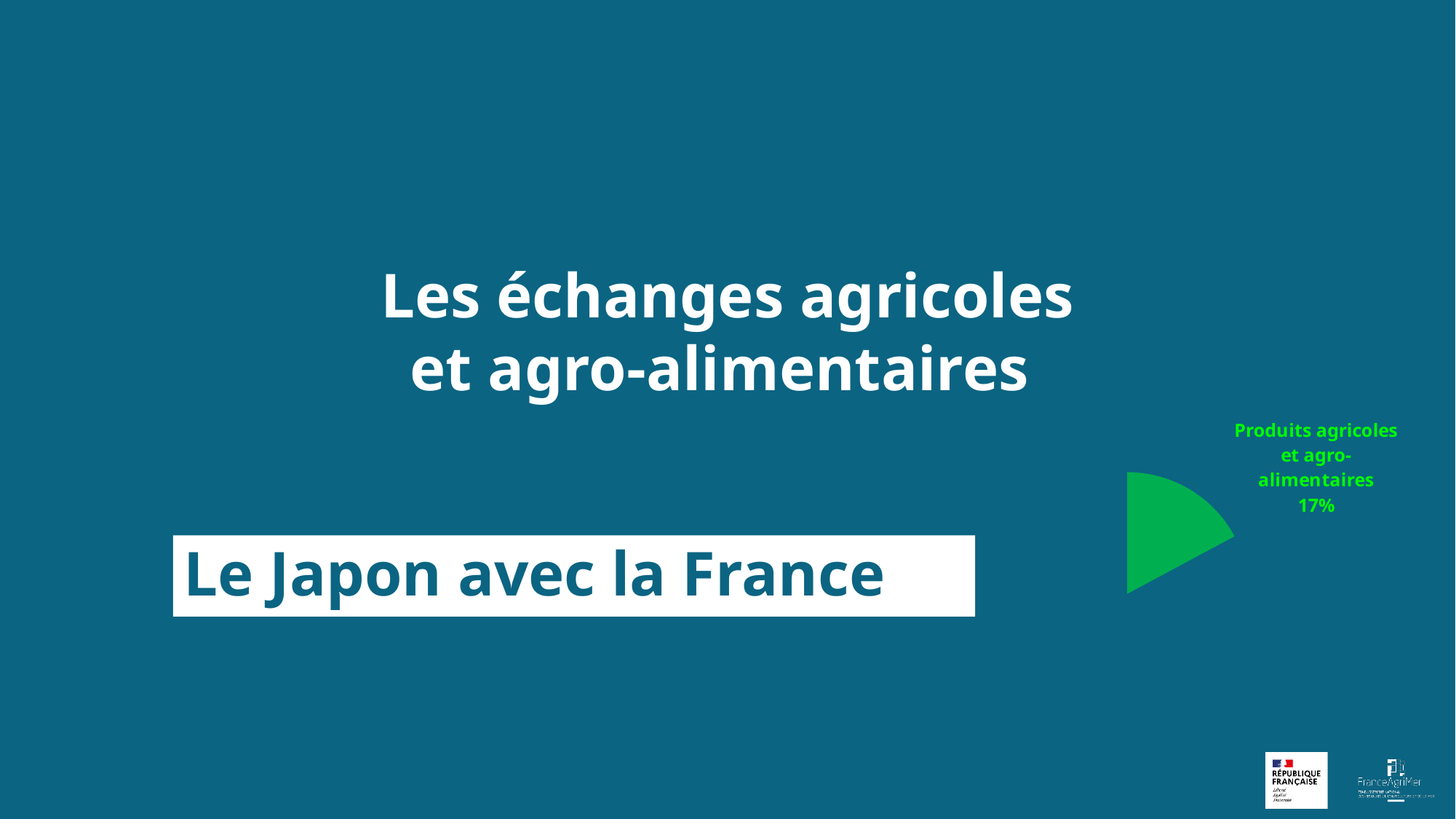
What share is shown for "Produits agricoles et agro-alimentaires" in the pie chart? 17% How many slices in the pie chart have a readable label? 1 Is the share for "Produits agricoles et agro-alimentaires" greater or less than 50%? less What is the label of the visible slice in the pie chart? Produits agricoles et agro-alimentaires What colour is the "Produits agricoles et agro-alimentaires" slice in the pie chart? green What kind of chart is shown on the right of the slide? pie chart